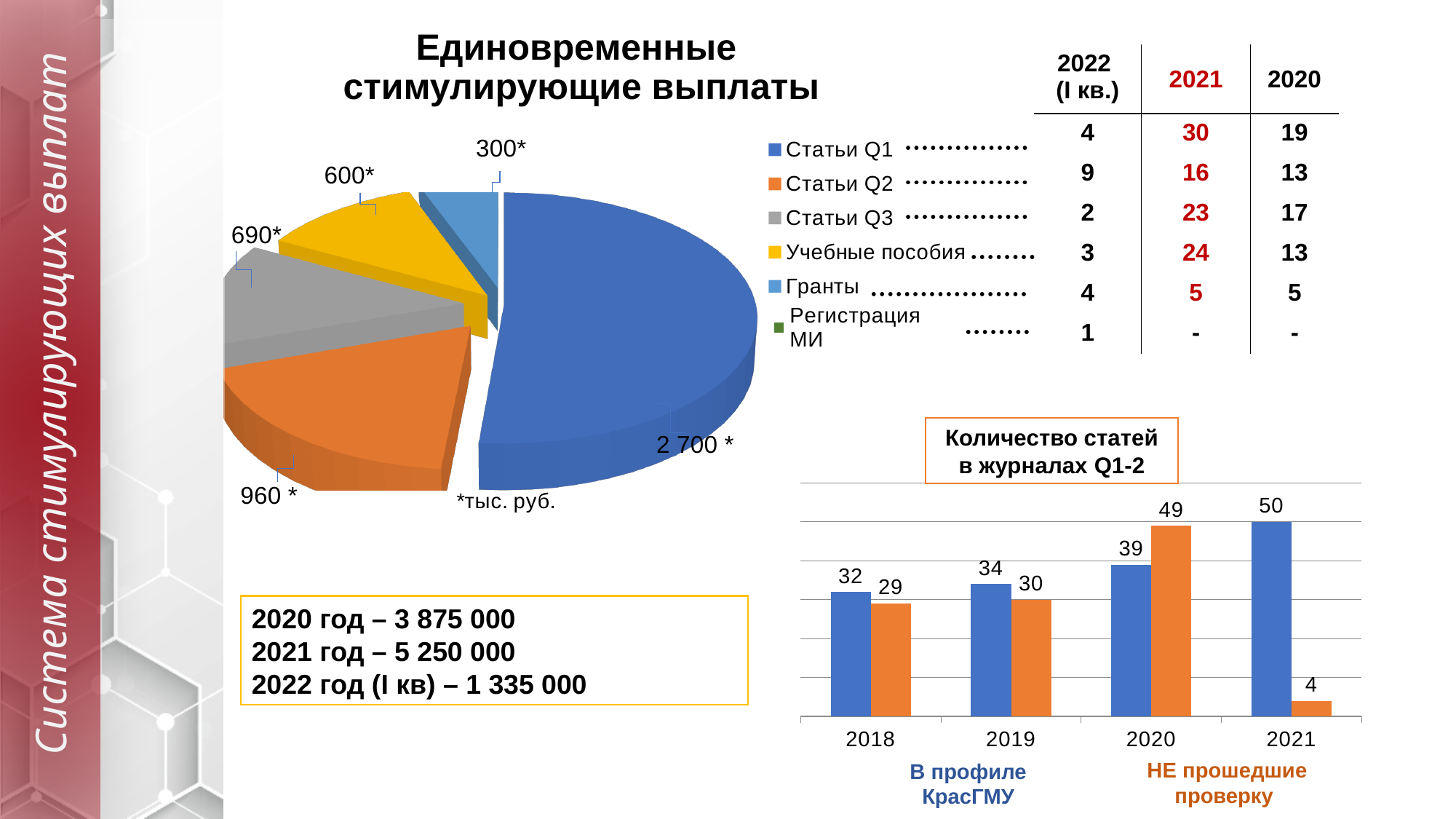
What type of chart is 'Единовременные стимулирующие выплаты'? pie chart In the bar chart 'Количество статей в журналах Q1-2', how many years are shown on the x axis? 4 In the bar chart 'Количество статей в журналах Q1-2', what is the value for 'НЕ прошедшие проверку' in 2020? 49 In the bar chart 'Количество статей в журналах Q1-2', what is the difference between 'В профиле КрасГМУ' and 'НЕ прошедшие проверку' in 2021? 46 In the bar chart 'Количество статей в журналах Q1-2', how many series are shown? 2 In the bar chart 'Количество статей в журналах Q1-2', which year has the highest value for 'В профиле КрасГМУ'? 2021 In the bar chart 'Количество статей в журналах Q1-2', what is the value for 'В профиле КрасГМУ' in 2021? 50 In the bar chart 'Количество статей в журналах Q1-2', which is larger in 2020: 'В профиле КрасГМУ' or 'НЕ прошедшие проверку'? НЕ прошедшие проверку In the pie chart 'Единовременные стимулирующие выплаты', what is the value labelled on the Статьи Q2 (orange) slice? 960 * In the bar chart 'Количество статей в журналах Q1-2', does the value for 'В профиле КрасГМУ' rise or fall from 2018 to 2021? rise In the pie chart 'Единовременные стимулирующие выплаты', what is the value labelled on the largest slice (Статьи Q1)? 2 700 * In the bar chart 'Количество статей в журналах Q1-2', which year has the lowest value for 'НЕ прошедшие проверку'? 2021